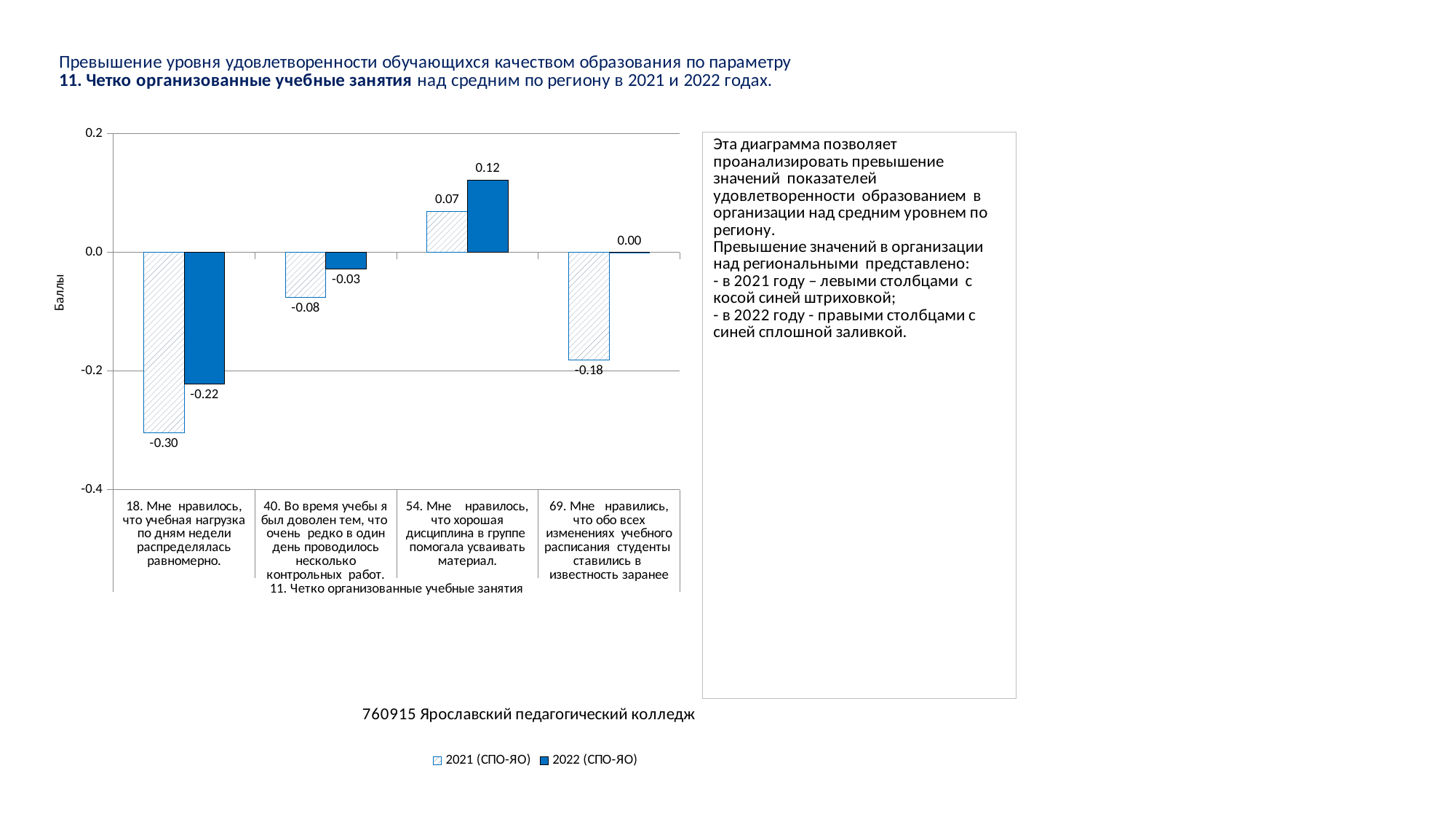
How many categories are shown on the x axis? 4 For category 54, which is larger: the 2021 value or the 2022 value? 2022 What is the label of the y axis? Баллы Which category has the lowest 2021 (СПО-ЯО) value? 18. Мне нравилось, что учебная нагрузка по дням недели распределялась равномерно. What is the 2021 (СПО-ЯО) value for category 18 (Мне нравилось, что учебная нагрузка по дням недели распределялась равномерно)? -0.30 What is the difference between the 2022 and 2021 values for category 18? 0.08 What is the 2022 (СПО-ЯО) value for category 69 (Мне нравились, что обо всех изменениях учебного расписания студенты ставились в известность заранее)? 0.00 What kind of chart is shown on the slide? Bar chart What is the 2021 (СПО-ЯО) value for category 40 (Во время учебы я был доволен тем, что очень редко в один день проводилось несколько контрольных работ)? -0.08 What is the 2022 (СПО-ЯО) value for category 54 (Мне нравилось, что хорошая дисциплина в группе помогала усваивать материал)? 0.12 Which category has the highest 2022 (СПО-ЯО) value? 54. Мне нравилось, что хорошая дисциплина в группе помогала усваивать материал. How many series does the legend list? 2